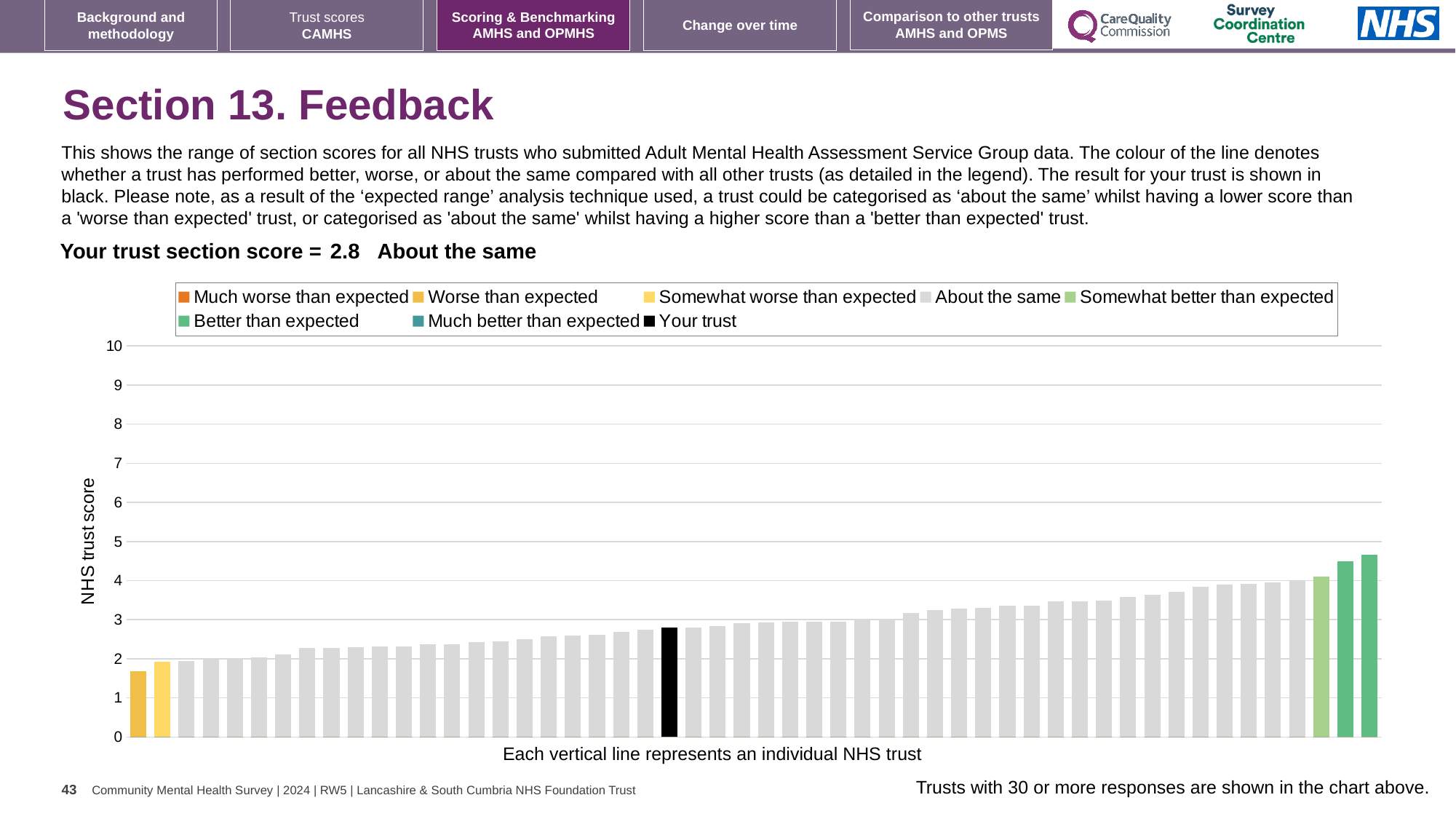
Is the value of the shortest bar (leftmost) greater or less than 2? less Is the value of the black 'Your trust' bar greater or less than 3? less Is the value of the tallest bar (rightmost) greater or less than 4? greater What is the label on the vertical axis of the chart? NHS trust score Which is larger, the score for your trust or the score of the rightmost bar? the rightmost bar What colour is used for the 'Your trust' bar in the chart? black What is the section score for your trust shown on the slide? 2.8 What kind of chart is shown on the slide? bar chart Do the bar values rise or fall from left to right along the x axis? rise How many bars are shown in the 'Better than expected' colour? 2 How many entries does the chart legend list? 8